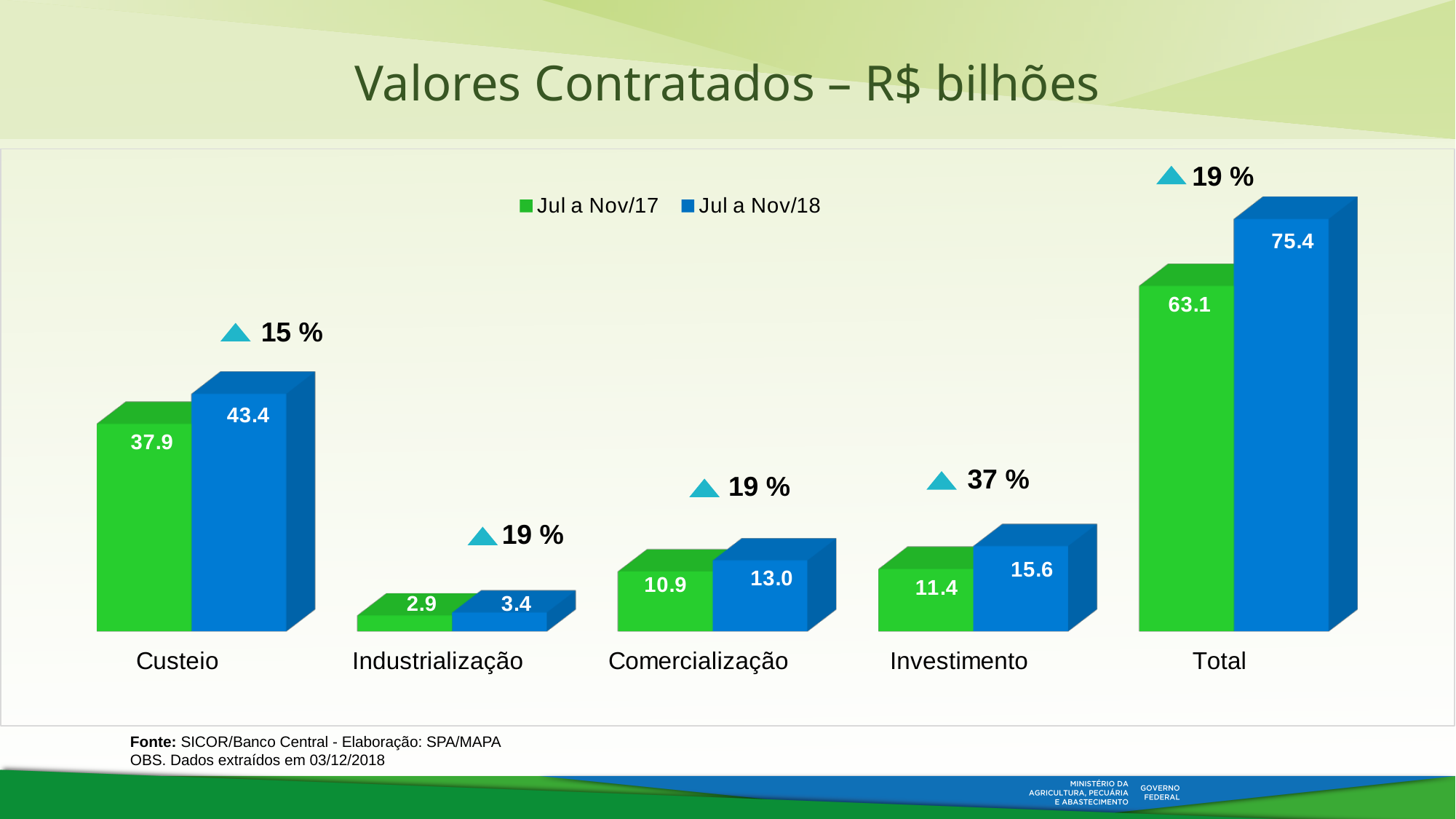
Excluding Total, which category has the highest value in the Jul a Nov/17 series? Custeio Which category has the lowest value in the Jul a Nov/18 series? Industrialização What percentage increase is shown above the Investimento bars? 37 % How many categories are shown on the x axis? 5 What is the Total value for Jul a Nov/17? 63.1 What is the value for Investimento in the Jul a Nov/18 series? 15.6 How many series does the legend list? 2 What is the difference between the Jul a Nov/18 and Jul a Nov/17 values for Comercialização? 2.1 What is the difference between the Total values for Jul a Nov/18 and Jul a Nov/17? 12.3 Which is larger: the Jul a Nov/17 value for Investimento or the Jul a Nov/17 value for Comercialização? Investimento What is the value for Industrialização in the Jul a Nov/17 series? 2.9 What is the value for Custeio in the Jul a Nov/18 series? 43.4